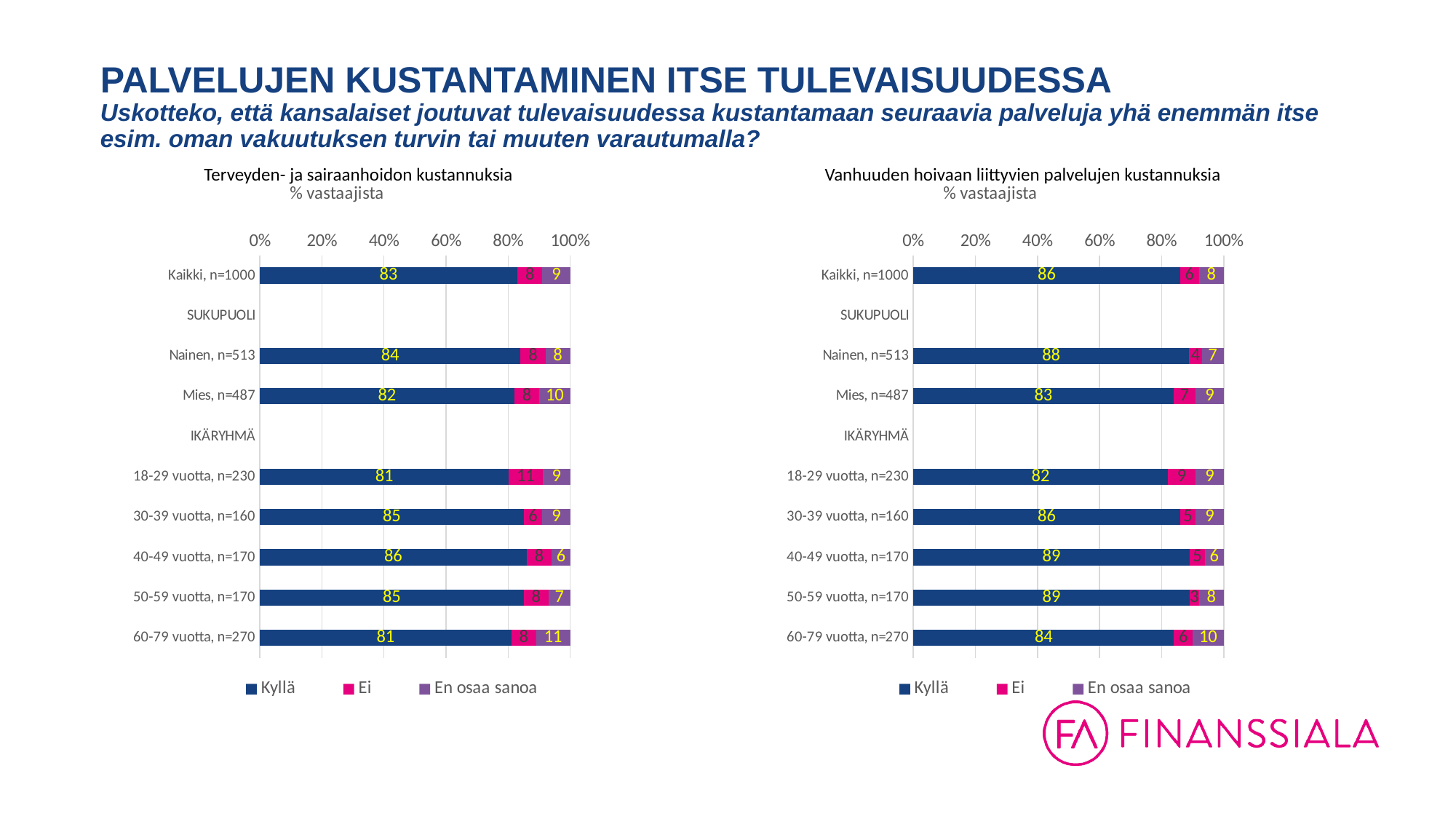
In the chart titled "Terveyden- ja sairaanhoidon kustannuksia", which category has the highest Kyllä value? 40-49 vuotta, n=170 In the chart titled "Vanhuuden hoivaan liittyvien palvelujen kustannuksia", which category has the lowest Kyllä value? 18-29 vuotta, n=230 How many respondent groups have bars plotted in the chart titled "Terveyden- ja sairaanhoidon kustannuksia"? 8 In the chart titled "Terveyden- ja sairaanhoidon kustannuksia", which is larger: the En osaa sanoa value for 60-79 vuotta, n=270 or for 40-49 vuotta, n=170? 60-79 vuotta, n=270 What kind of chart is the chart titled "Vanhuuden hoivaan liittyvien palvelujen kustannuksia"? Stacked bar chart In the chart titled "Vanhuuden hoivaan liittyvien palvelujen kustannuksia", what is the difference between the Kyllä values for Nainen, n=513 and Mies, n=487? 5 How many series does the legend of the chart titled "Vanhuuden hoivaan liittyvien palvelujen kustannuksia" list? 3 In the chart titled "Terveyden- ja sairaanhoidon kustannuksia", what is the total of the stacked bar for Mies, n=487? 100 In the chart titled "Vanhuuden hoivaan liittyvien palvelujen kustannuksia", which category has the lowest Ei value? 50-59 vuotta, n=170 In the chart titled "Vanhuuden hoivaan liittyvien palvelujen kustannuksia", what is the Ei value for Nainen, n=513? 4 In the chart titled "Terveyden- ja sairaanhoidon kustannuksia", which category has the highest Ei value? 18-29 vuotta, n=230 In the chart titled "Terveyden- ja sairaanhoidon kustannuksia", what is the Kyllä value for Kaikki, n=1000? 83